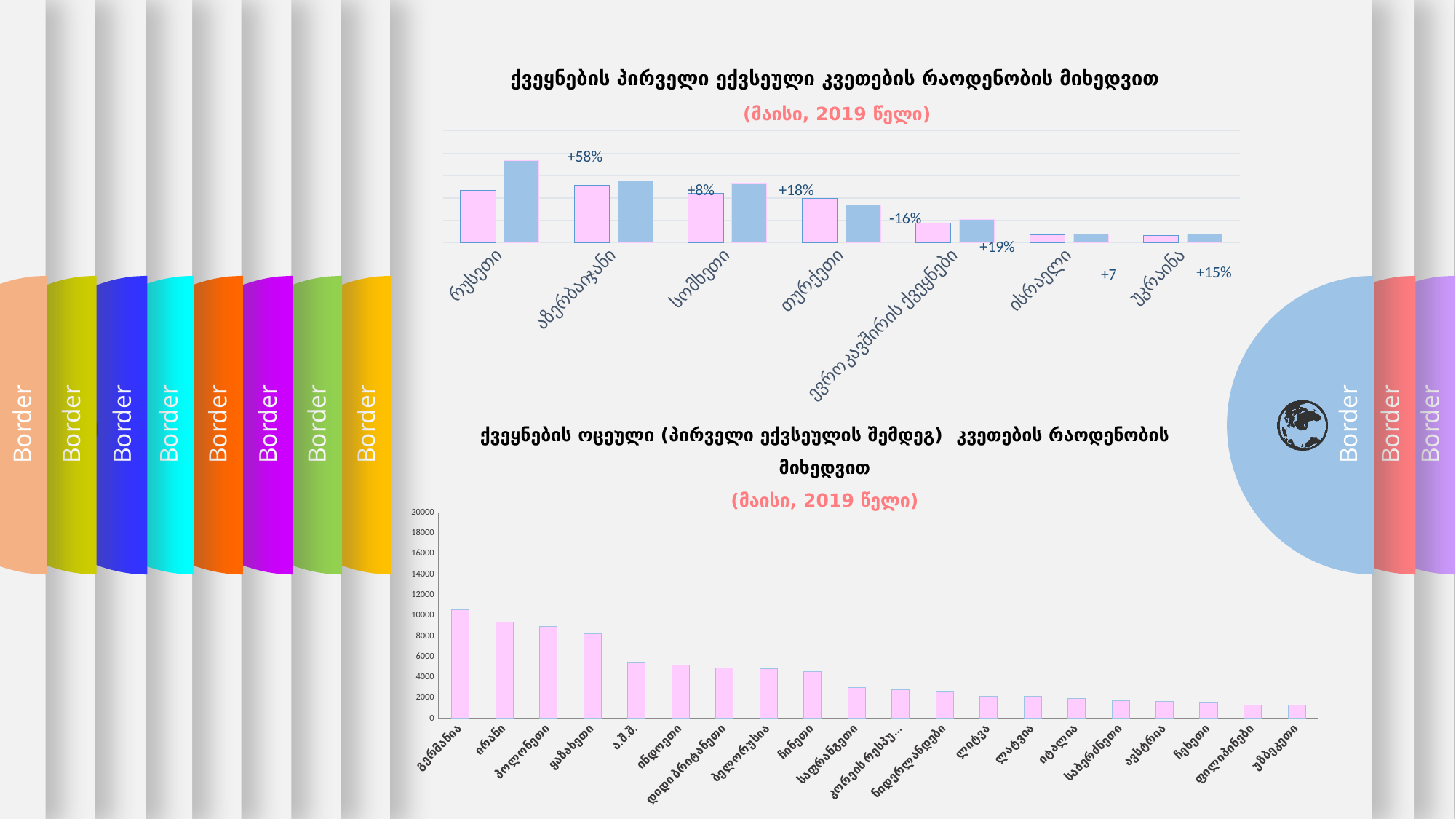
In the bottom chart, how many countries are shown on the x axis? 20 In the bottom chart, is the value for გერმანია greater or less than 8000? greater In the bottom chart, is the value for ლიტვა greater or less than 4000? less In the top chart, which has taller bars, რუსეთი or თურქეთი? რუსეთი What kind of chart is the bottom chart? bar chart What period is given in the subtitle of the top chart? (მაისი, 2019 წელი) In the bottom chart, do the values generally rise or fall from left to right along the x axis? fall In the bottom chart, which country has the highest value? გერმანია In the top chart, how many countries are shown on the x axis? 7 In the bottom chart, is the value for ა.შ.შ. greater or less than 6000? less In the top chart, which country has the tallest bar? რუსეთი What kind of chart is the top chart titled "ქვეყნების პირველი ექვსეული კვეთების რაოდენობის მიხედვით"? bar chart